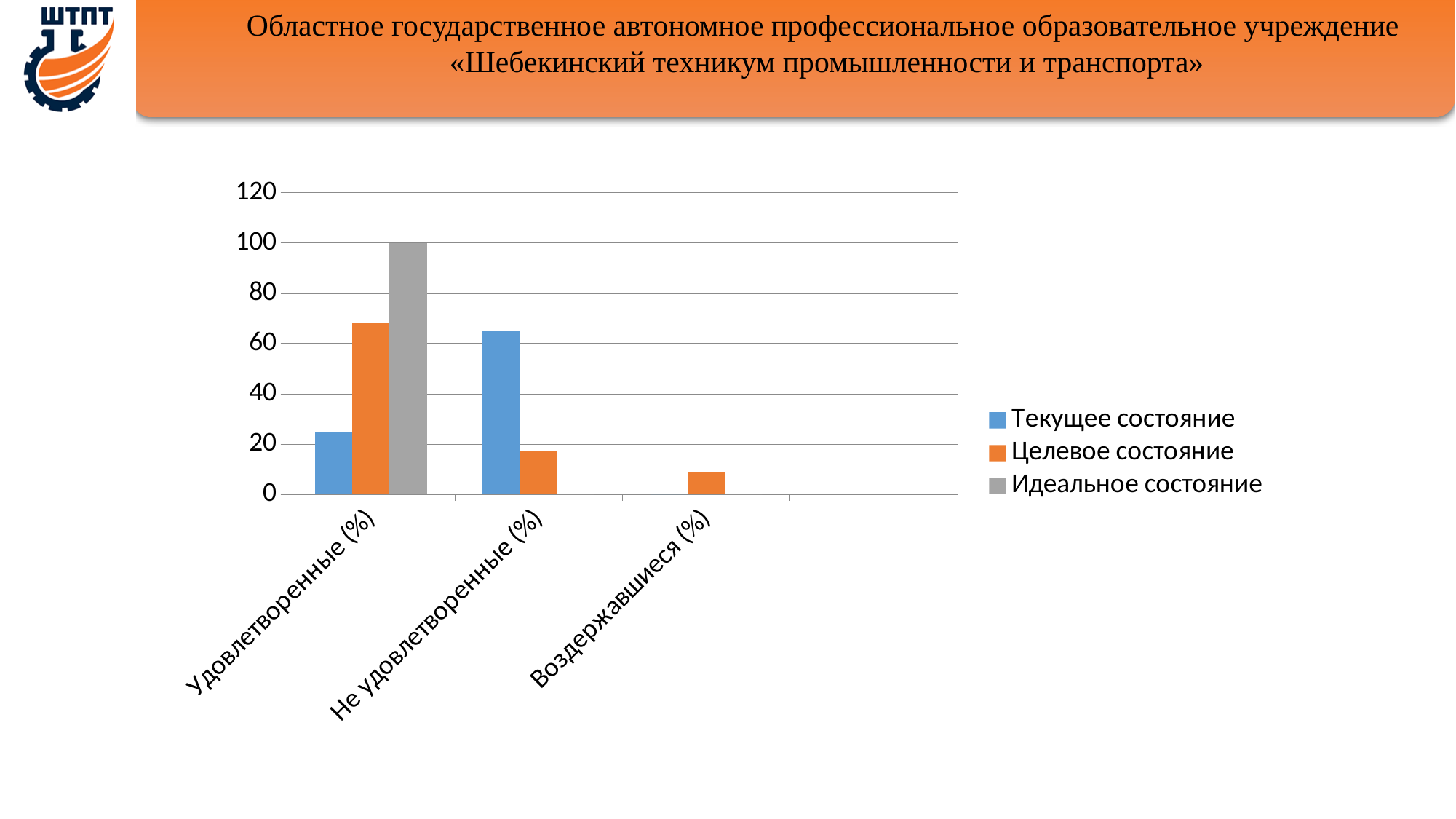
Which series has the highest value for Удовлетворенные (%)? Идеальное состояние Which category has the lowest value for Целевое состояние? Воздержавшиеся (%) What colour represents Целевое состояние in the legend? orange How many series does the legend list? 3 Is the value of Целевое состояние for Воздержавшиеся (%) greater or less than 20? less Is the value of Целевое состояние for Удовлетворенные (%) greater or less than 60? greater How many categories are shown on the x axis? 3 What is the value of Идеальное состояние for Удовлетворенные (%)? 100 Is the value of Текущее состояние for Не удовлетворенные (%) greater or less than 60? greater What type of chart is shown on the slide? bar chart For Текущее состояние, which category has the larger value: Удовлетворенные (%) or Не удовлетворенные (%)? Не удовлетворенные (%)